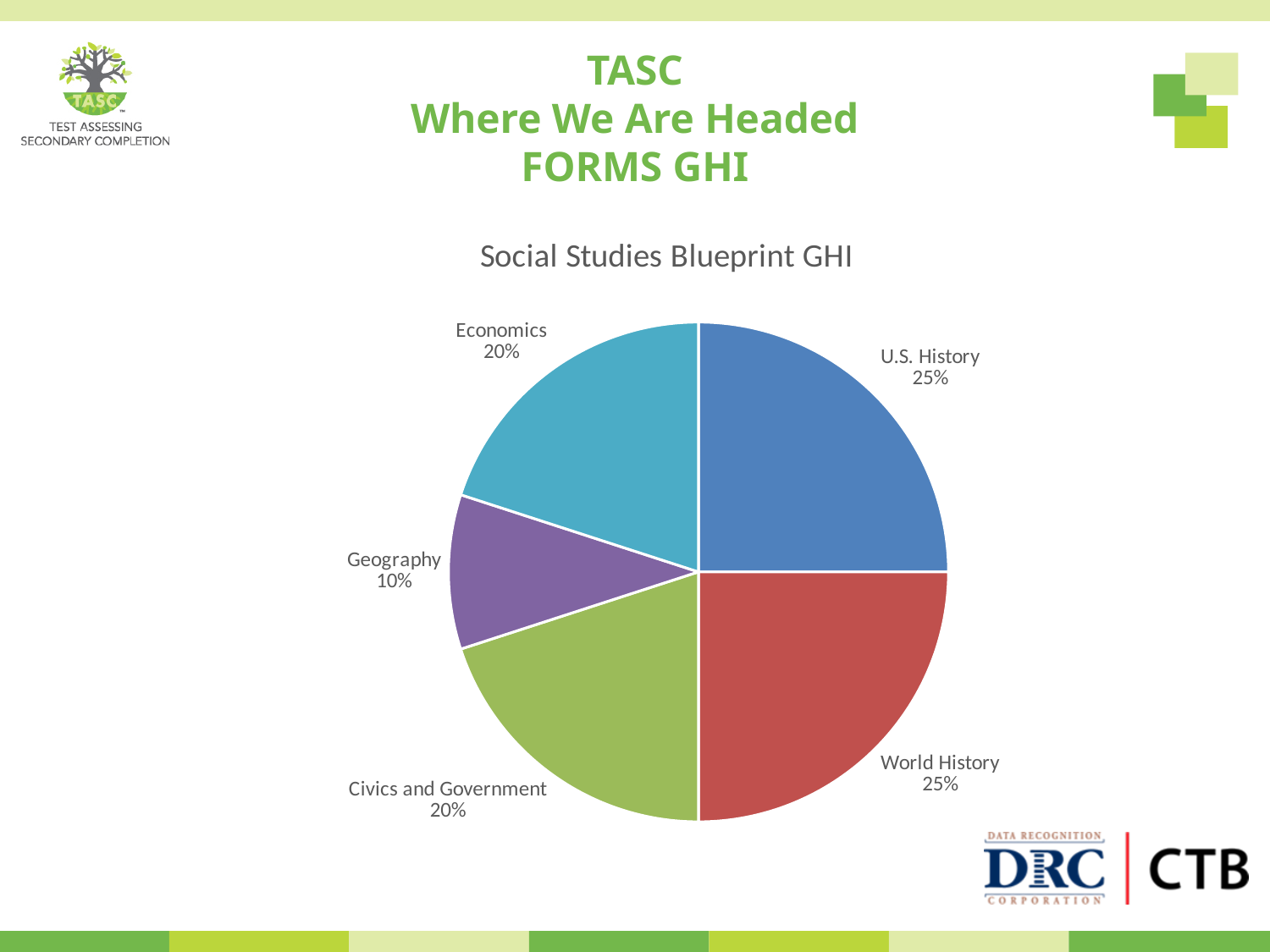
What kind of chart is shown on the slide? Pie chart What share of the pie does Economics represent? 20% What is the difference between the shares for U.S. History and Geography? 15% How many categories are shown in the pie chart? 5 What is the difference between the shares for World History and Economics? 5% What share of the pie does U.S. History represent? 25% Which category has the smallest slice of the pie? Geography What colour is the World History slice? Red What share of the pie does Geography represent? 10% Which is larger, the share for Civics and Government or the share for Geography? Civics and Government What share of the pie does Civics and Government represent? 20% What is the title of the chart? Social Studies Blueprint GHI